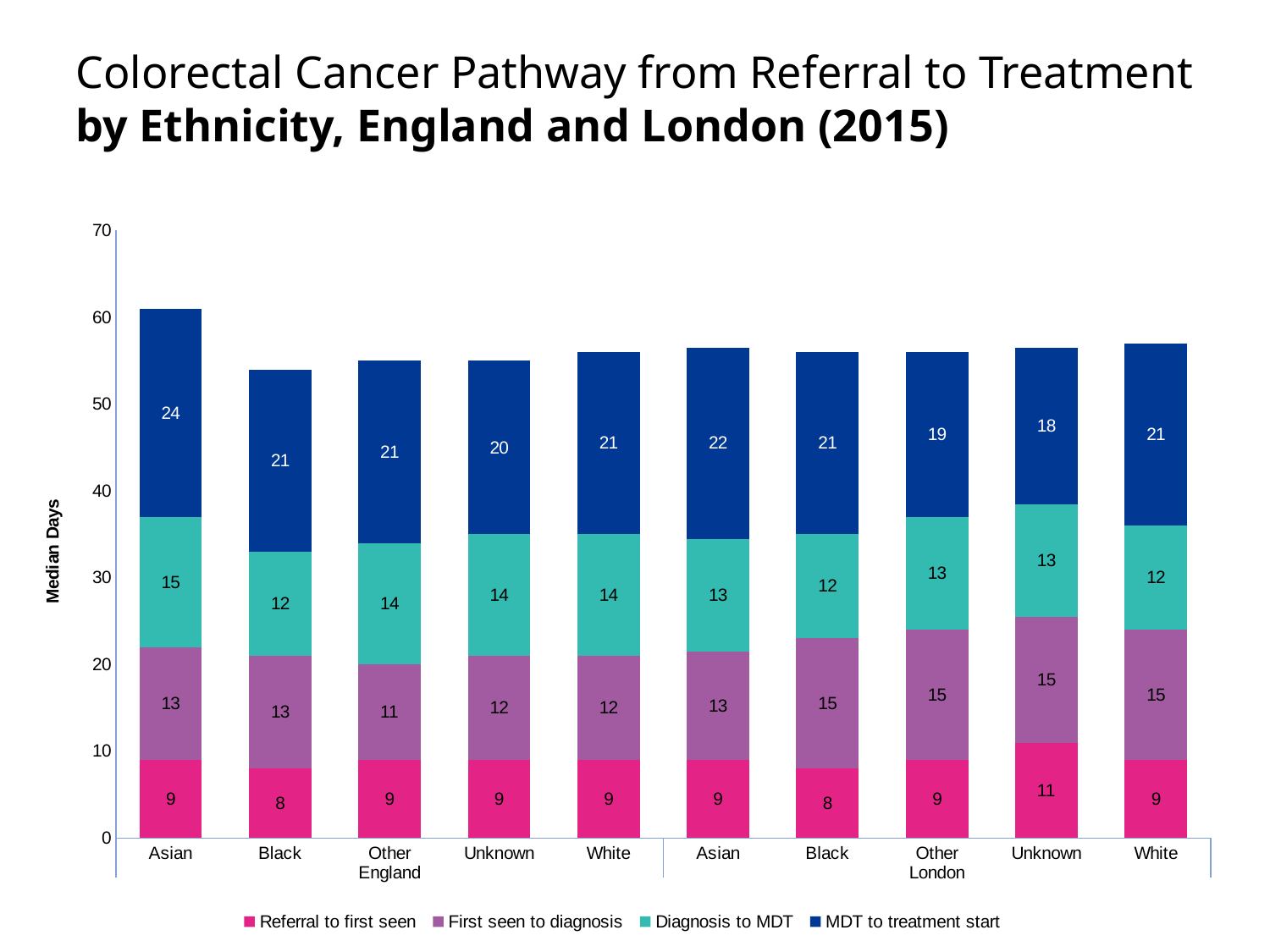
Is the total bar height for the Black group in England greater or less than 60? less For the Black group, is the First seen to diagnosis value larger in England or in London? London Which group has the lowest value for MDT to treatment start? Unknown (London) What kind of chart is shown on the slide? Stacked bar chart How many stacked bars are plotted in the chart? 10 How many series does the legend list? 4 What is the label on the vertical axis? Median Days What is the median number of days from MDT to treatment start for the Asian group in England? 24 What is the median number of days from referral to first seen for the Unknown group in London? 11 What is the total median days from referral to treatment for the Asian group in England? 61 What is the difference in Diagnosis to MDT days between the Asian and Black groups in England? 3 Which group has the highest value for MDT to treatment start? Asian (England)